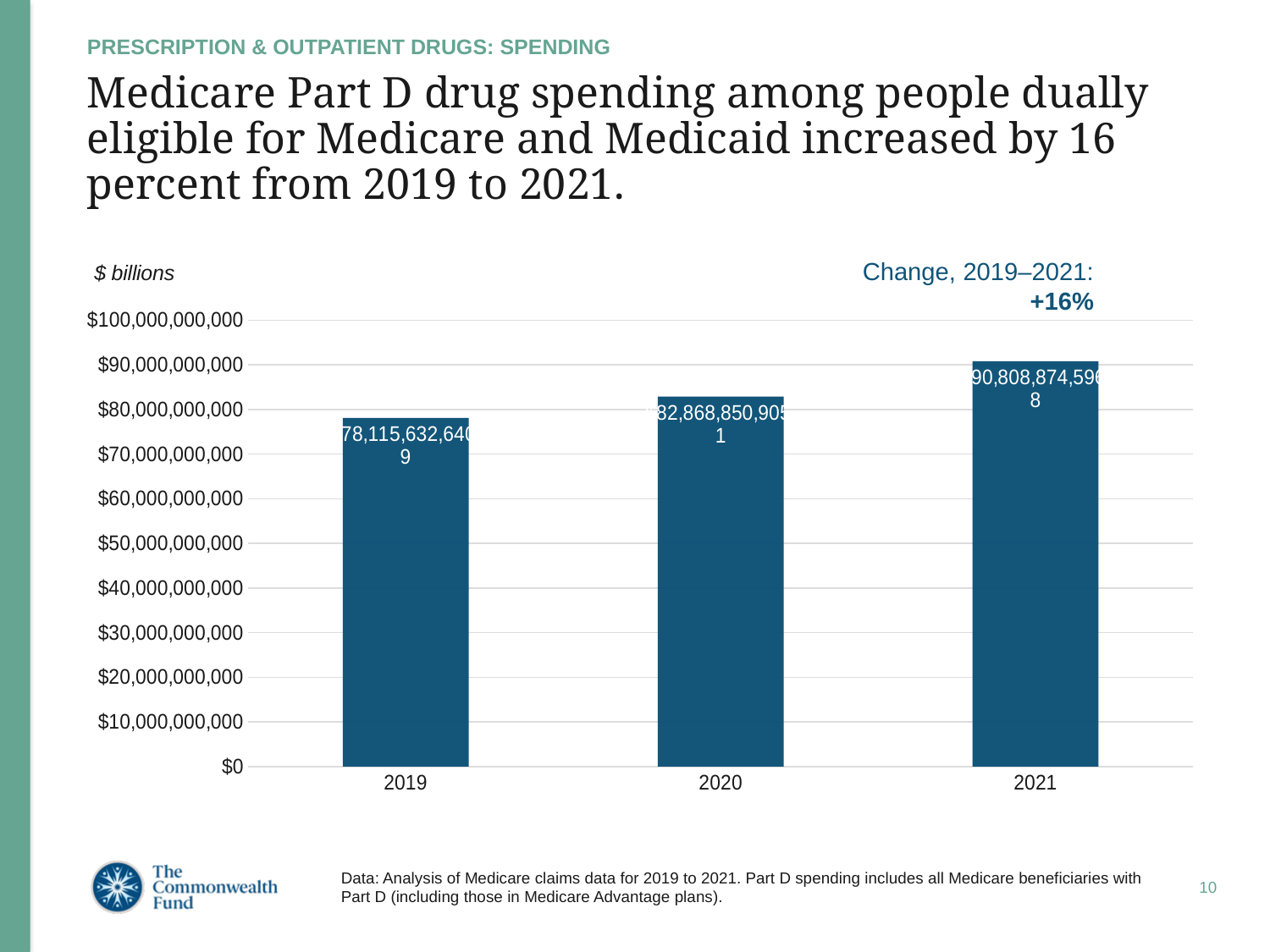
What is the highest value shown on the y axis? $100,000,000,000 Is the value for 2019 greater or less than $80,000,000,000? less Is spending higher in 2020 or in 2019? 2020 Which year has the highest Medicare Part D drug spending? 2021 Is spending higher in 2021 or in 2020? 2021 How many years are plotted on the chart? 3 What kind of chart is shown on the slide? bar chart Do the values rise or fall from 2019 to 2021? rise Is the value for 2020 greater or less than $80,000,000,000? greater Is the value for 2021 greater or less than $90,000,000,000? greater Which year has the lowest Medicare Part D drug spending? 2019 What percentage change from 2019 to 2021 is shown on the chart? +16%